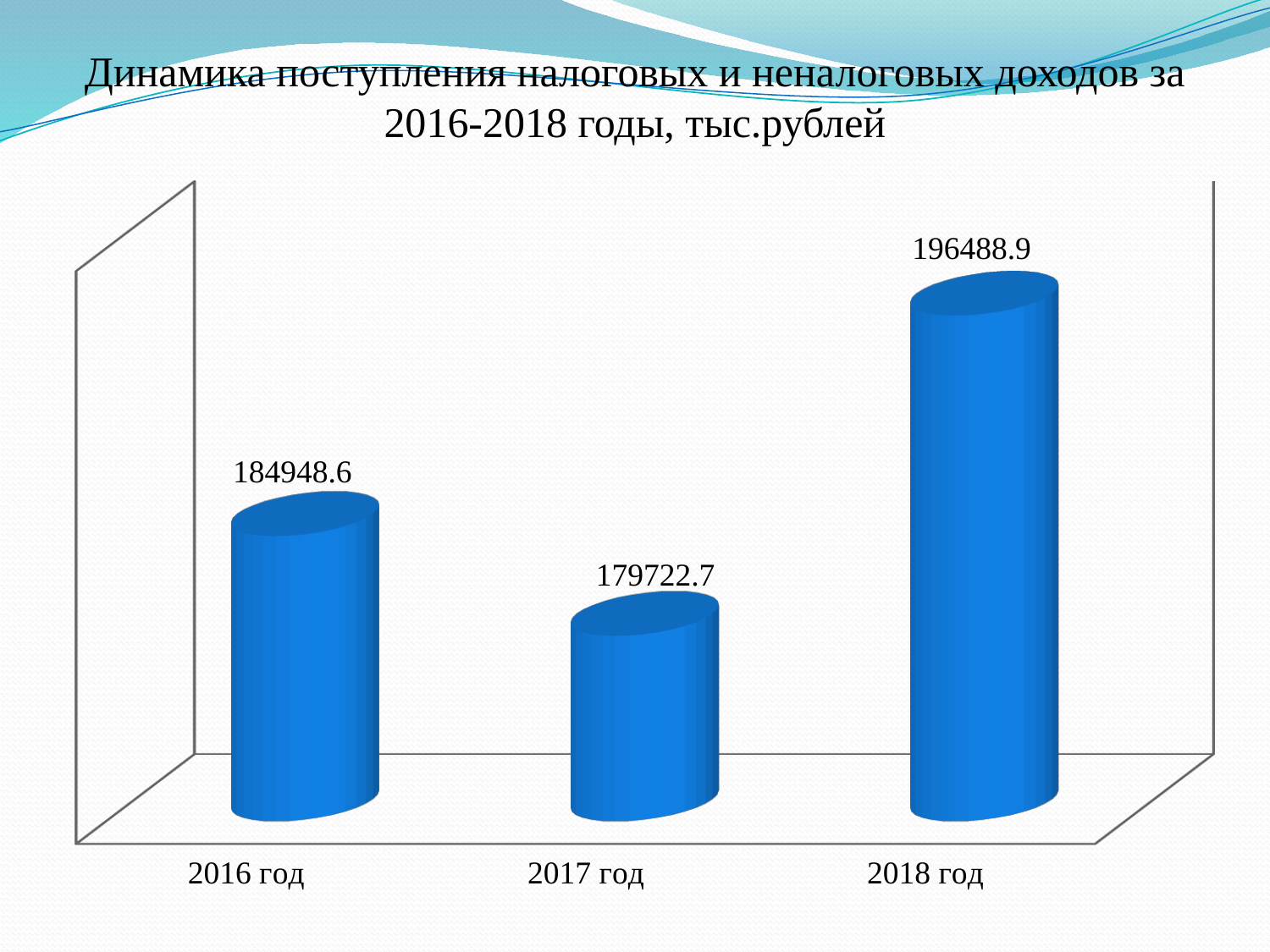
What is the value for 2016 год? 184948.6 What is the value for 2017 год? 179722.7 How many categories are shown on the chart? 3 Which year has the highest value? 2018 год What is the difference between the values for 2018 год and 2016 год? 11540.3 Does the value rise or fall from 2017 год to 2018 год? Rise What is the difference between the values for 2016 год and 2017 год? 5225.9 What kind of chart is shown on the slide? Bar chart What is the difference between the values for 2018 год and 2017 год? 16766.2 Which year has the lowest value? 2017 год What is the value for 2018 год? 196488.9 Which is larger, the value for 2016 год or the value for 2017 год? 2016 год